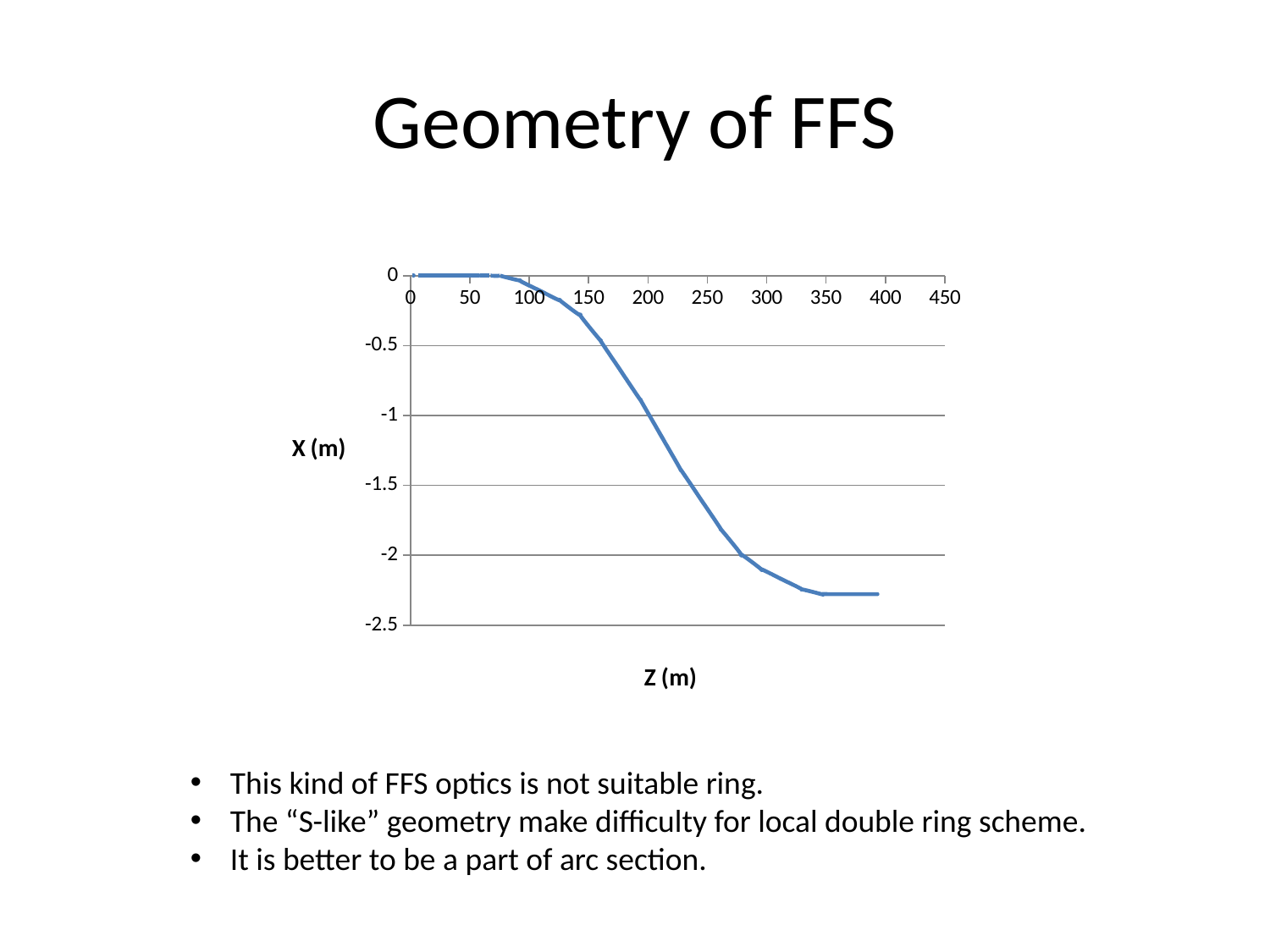
Is the value of X at Z = 250 greater or less than -1? less Is the value of X at Z = 50 greater or less than -0.5? greater Is X larger at Z = 100 or at Z = 300? Z = 100 How many lines are plotted on the chart? 1 What is the label of the horizontal axis of the chart? Z (m) What is the label of the vertical axis of the chart? X (m) Is the value of X at Z = 350 greater or less than -2? less Does X reach its lowest value at the smallest or the largest Z values plotted? largest Z values Does the plotted X value rise or fall as Z increases along the x axis? fall What kind of chart is shown on the slide? line chart